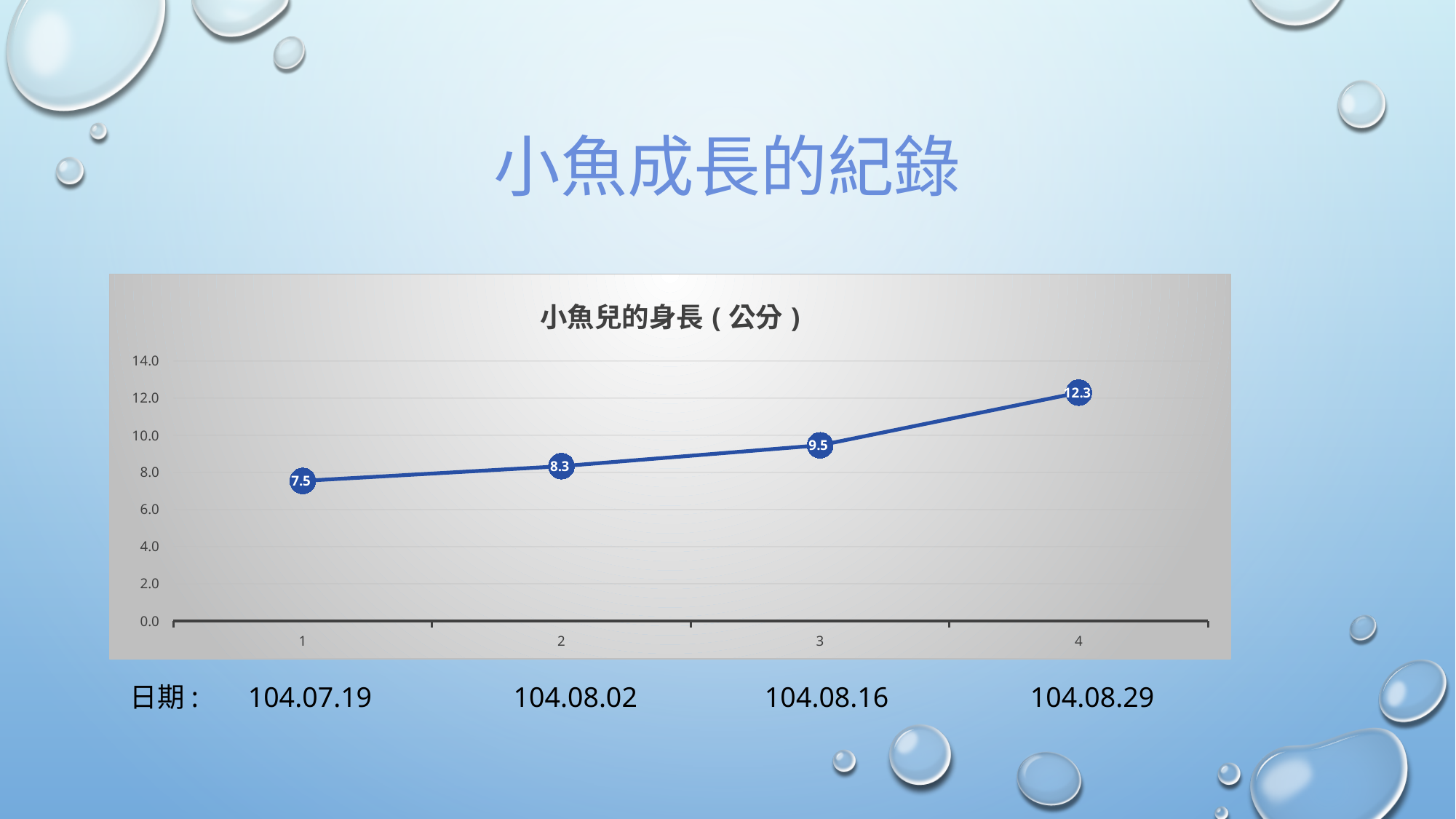
Do the values rise or fall from point 1 to point 4? rise Which point has the lowest value in the chart? 1 What is the value at point 1 in the chart? 7.5 What kind of chart is shown on the slide? line chart What is the difference between the values at point 4 and point 1? 4.8 How many data points are plotted in the chart? 4 What is the value at point 2 in the chart? 8.3 What is the difference between the values at point 3 and point 2? 1.2 Which point has the highest value in the chart? 4 What is the value at point 4 in the chart? 12.3 Which is larger, the value at point 2 or the value at point 3? point 3 What is the value at point 3 in the chart? 9.5